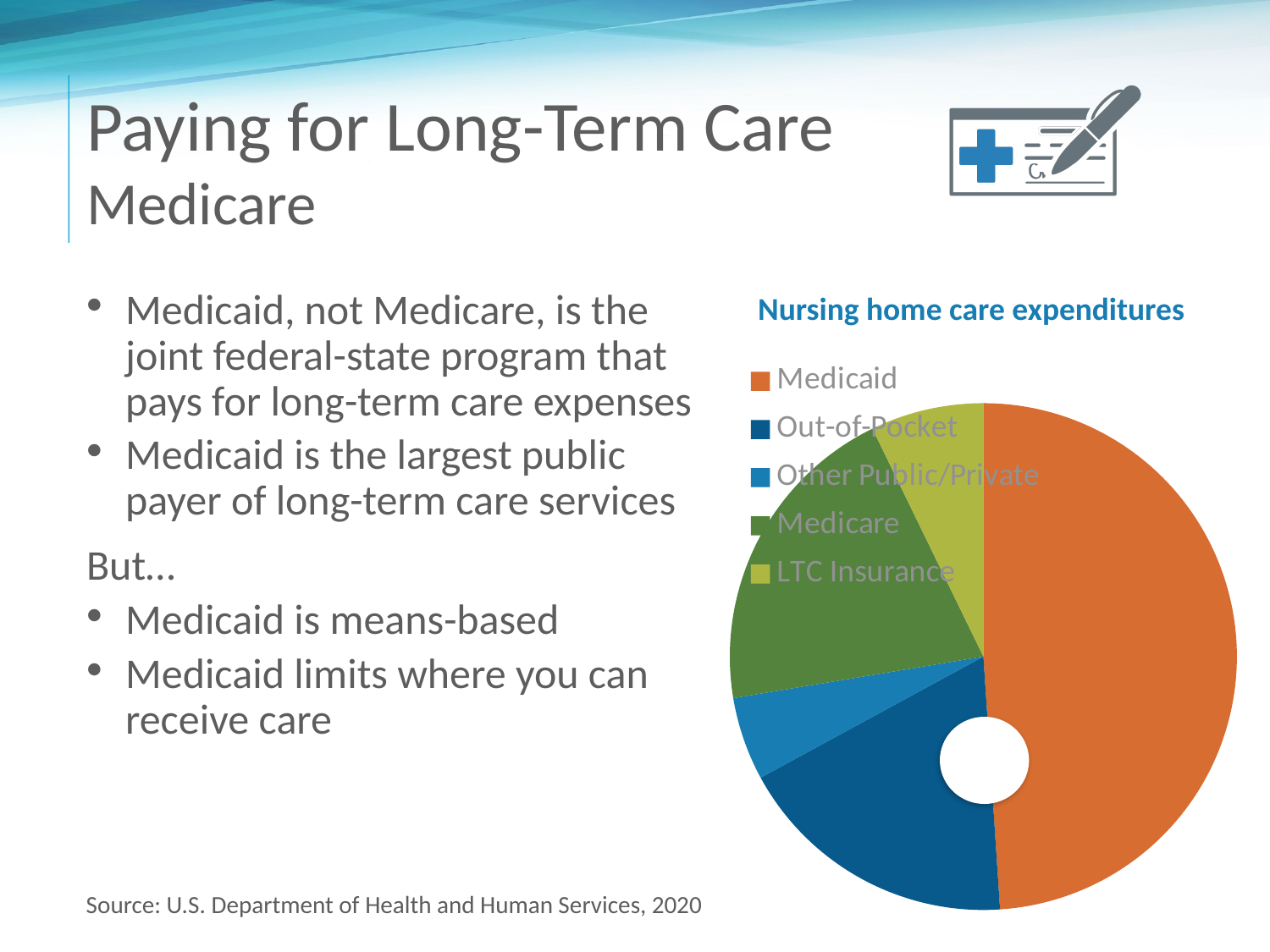
Which category has the largest share of nursing home care expenditures? Medicaid What colour is the Medicaid slice in the pie chart? orange Which is larger, the share for Medicaid or the share for Out-of-Pocket? Medicaid How many slices does the pie chart have? 5 Which is larger, the share for Medicare or the share for Other Public/Private? Medicare How many entries does the chart's legend list? 5 What kind of chart is shown on the slide? pie chart What is the title of the chart? Nursing home care expenditures Which is larger, the share for Medicaid or the share for Medicare? Medicaid